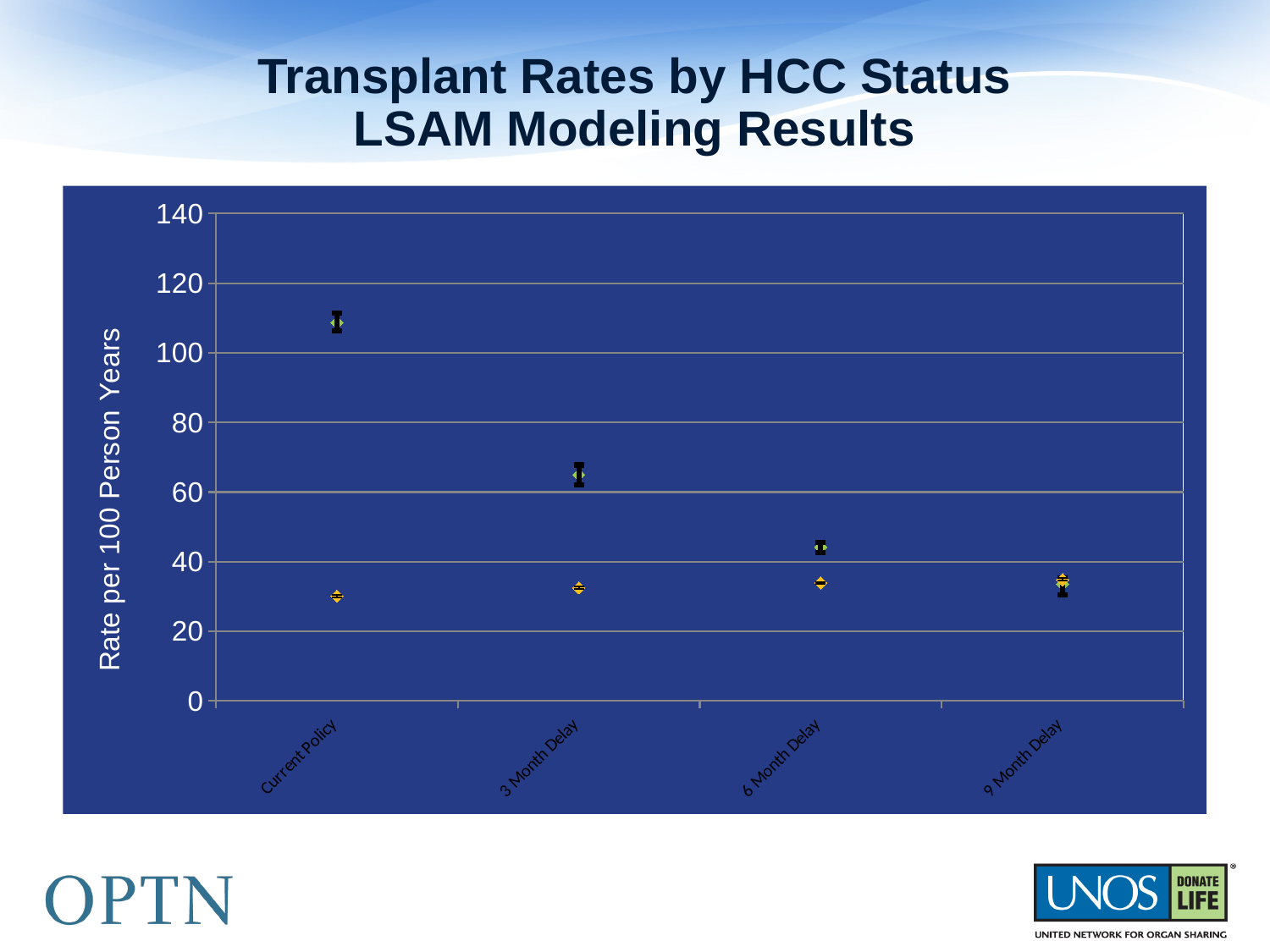
How many categories are shown along the x axis of the chart? 4 Is the value of the upper (green) point for Current Policy greater or less than 120? less Is the value of the upper (green) point for 3 Month Delay greater or less than 60? greater Is the value of the upper (green) point for 3 Month Delay greater or less than 80? less Do the values of the upper (green) series rise or fall from Current Policy to 9 Month Delay? fall What is the label on the vertical axis of the chart? Rate per 100 Person Years What is the title of the chart on the slide? Transplant Rates by HCC Status LSAM Modeling Results What kind of chart is shown on the slide? scatter chart